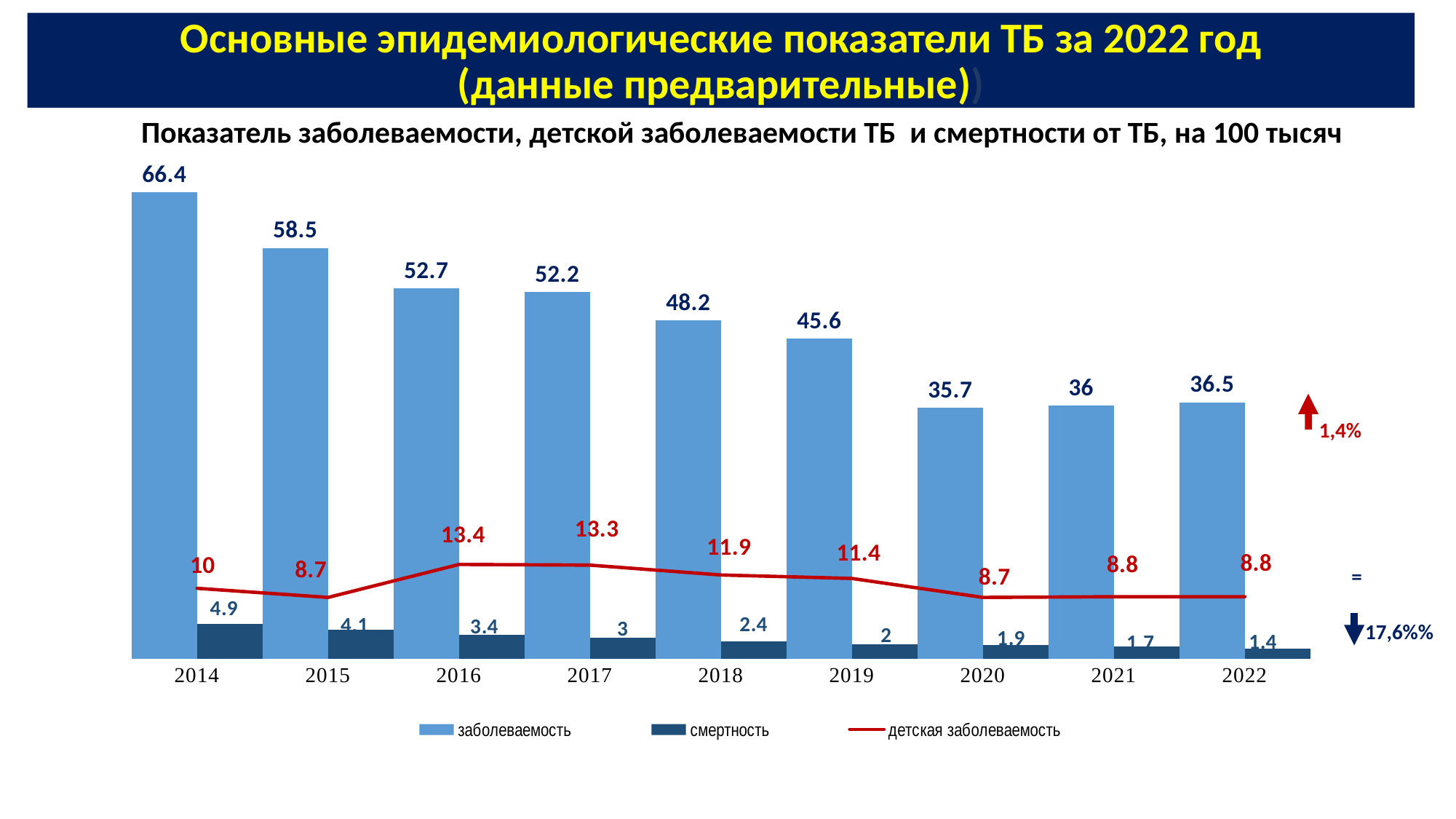
How many years are shown on the x axis? 9 Which year has the highest заболеваемость value? 2014 What is the value of детская заболеваемость for 2017? 13.3 What is the value of заболеваемость for 2014? 66.4 What kind of chart is used for the заболеваемость and смертность series? bar chart Which year has the highest детская заболеваемость value? 2016 What is the difference between the заболеваемость values for 2014 and 2022? 29.9 Does the смертность series rise or fall from 2014 to 2022? fall What is the value of смертность for 2022? 1.4 Which is larger, the заболеваемость value for 2020 or for 2021? 2021 How many series does the legend list? 3 Which year has the lowest смертность value? 2022